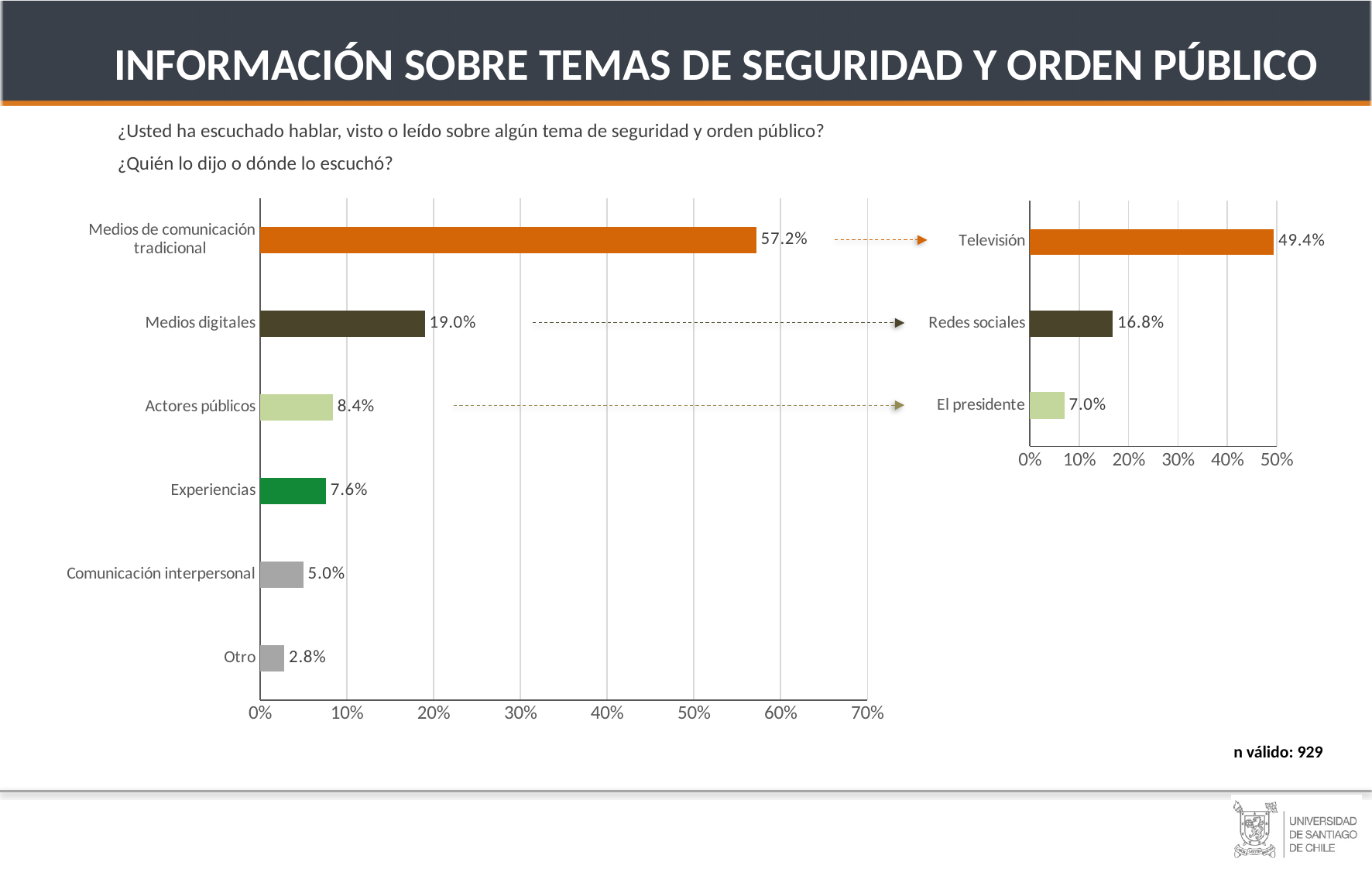
In the left chart, which is larger: Comunicación interpersonal or Experiencias? Experiencias What is the valid n reported on the slide? 929 What type of chart is the left chart? Bar chart In the left chart, what is the value for Medios de comunicación tradicional? 57.2% In the right chart, what is the difference between Televisión and El presidente? 42.4% In the left chart, what is the value for Experiencias? 7.6% How many categories are shown in the right chart? 3 In the left chart, what is the difference between Medios digitales and Actores públicos? 10.6% In the left chart, which category has the lowest value? Otro In the right chart, which category has the highest value? Televisión How many categories are shown in the left chart? 6 In the right chart, what is the value for Redes sociales? 16.8%